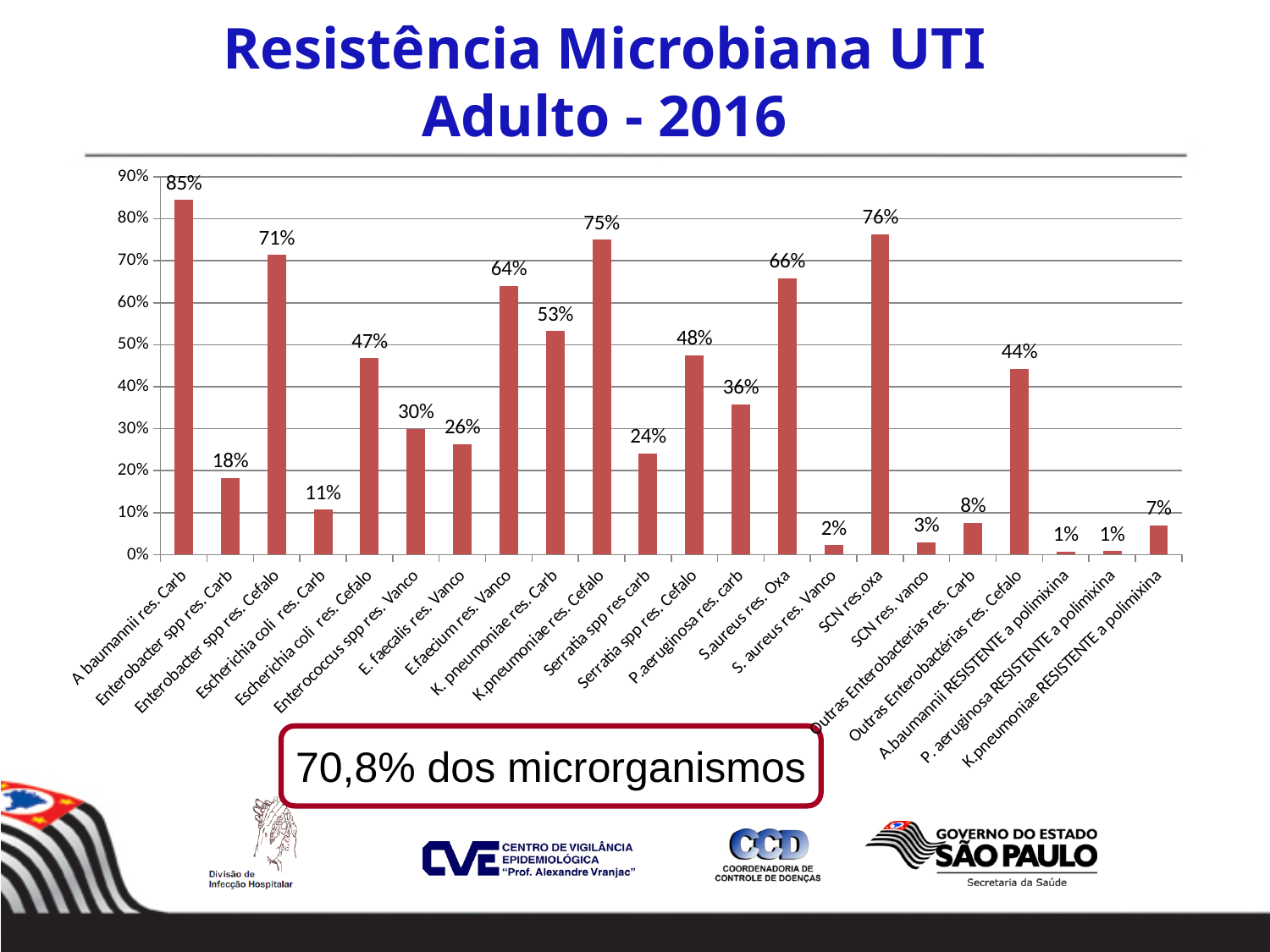
Which category has the highest value in the chart? A.baumannii res. Carb How many categories are plotted in the chart? 22 What is the value shown for K.pneumoniae res. Cefalo? 75% Which is larger, the value for E.faecium res. Vanco or the value for E. faecalis res. Vanco? E.faecium res. Vanco What is the difference between the values for Enterobacter spp res. Cefalo and Enterobacter spp res. Carb? 53% What is the difference between the values for S.aureus res. Oxa and S. aureus res. Vanco? 64% What is the value shown for Escherichia coli res. Carb? 11% What type of chart is shown on the slide? bar chart Is the value for K. pneumoniae res. Carb greater or less than 50%? greater What is the title of the slide containing the chart? Resistência Microbiana UTI Adulto - 2016 What is the resistance value for A.baumannii res. Carb? 85% What is the value shown for SCN res.oxa? 76%